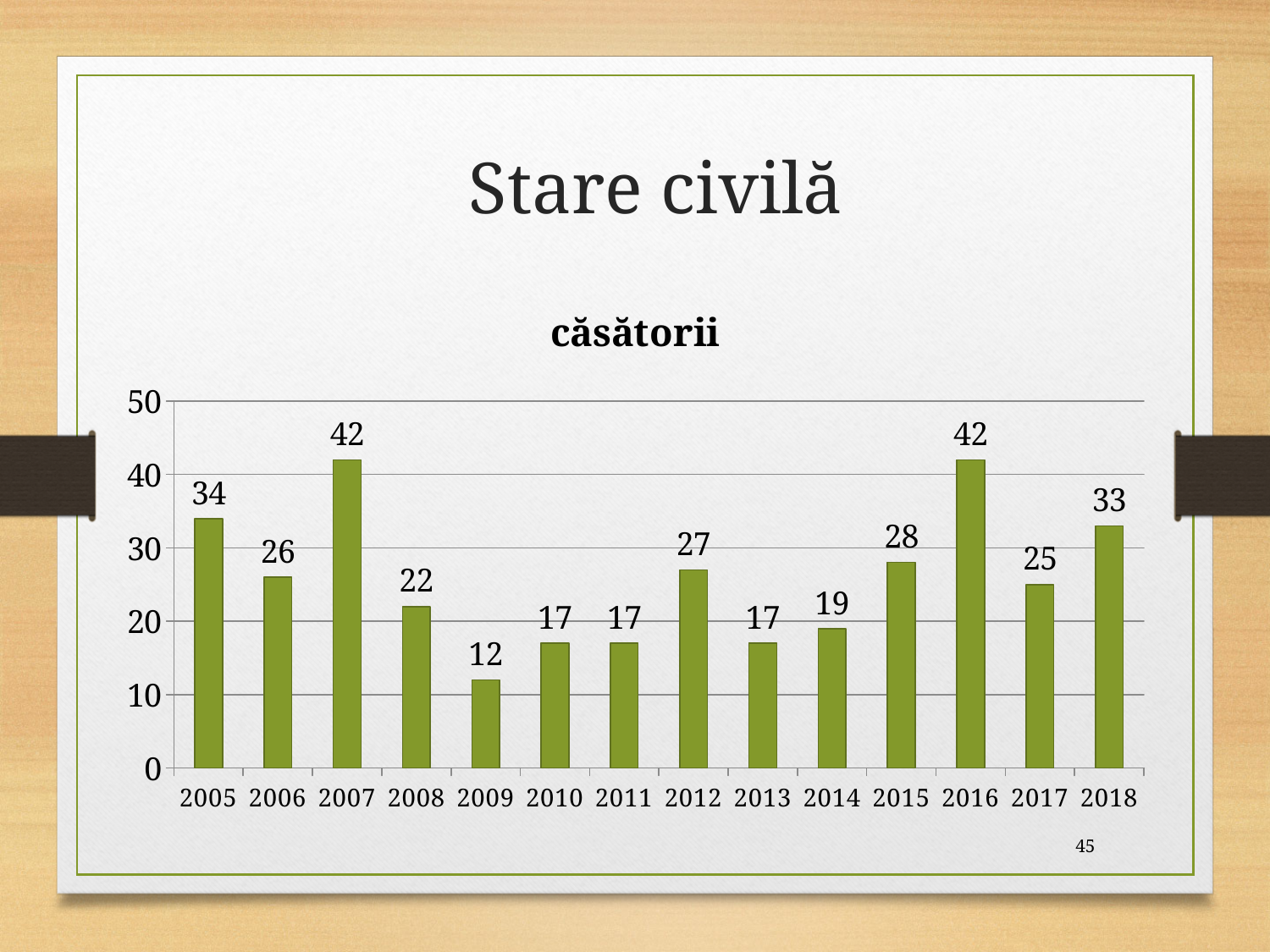
What is the difference between the values for 2005 and 2006 in the căsătorii chart? 8 Which year has the lowest value in the căsătorii chart? 2009 What is the title of the chart on the slide? căsătorii What is the value for 2007 in the căsătorii chart? 42 What is the difference between the values for 2016 and 2017 in the căsătorii chart? 17 Which is larger in the căsătorii chart, the value for 2012 or the value for 2015? 2015 How many years are shown on the x axis of the căsătorii chart? 14 What kind of chart is shown on the slide? bar chart What is the value for 2018 in the căsătorii chart? 33 Do the values in the căsătorii chart rise or fall from 2007 to 2009? fall What is the value for 2014 in the căsătorii chart? 19 Is the value for 2008 in the căsătorii chart greater or less than 30? less